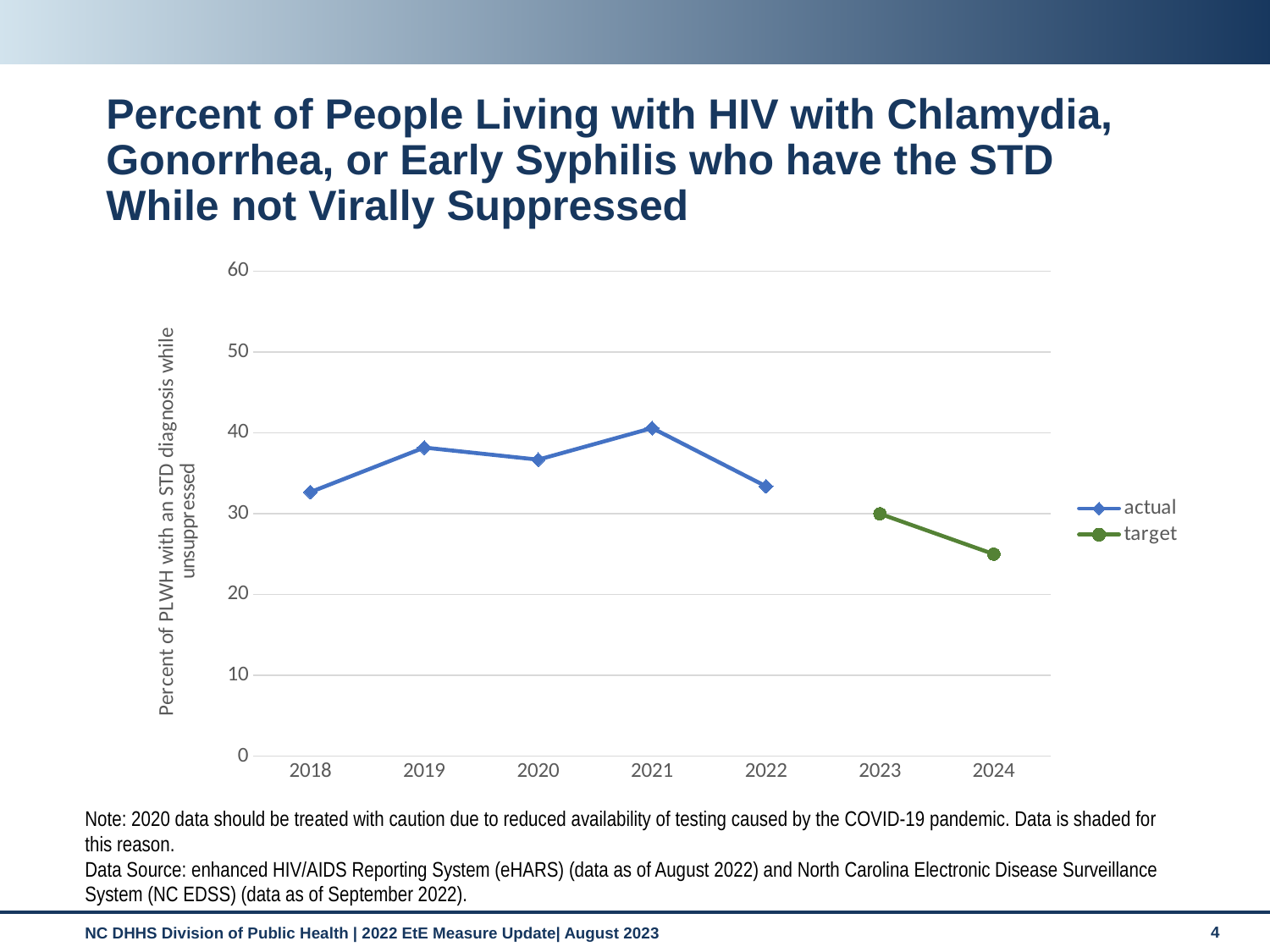
In which year is the actual value highest? 2021 Is the target value for 2024 greater or less than 30? less How many series does the legend list? 2 Does the target series rise or fall from 2023 to 2024? fall How many years are shown on the x axis? 7 What are the two entries listed in the legend? actual, target In which year is the actual value lowest? 2018 Is the actual value for 2018 greater or less than 30? greater What kind of chart is shown on the slide? line chart Which year has the larger actual value, 2019 or 2020? 2019 Which year has the larger actual value, 2021 or 2022? 2021